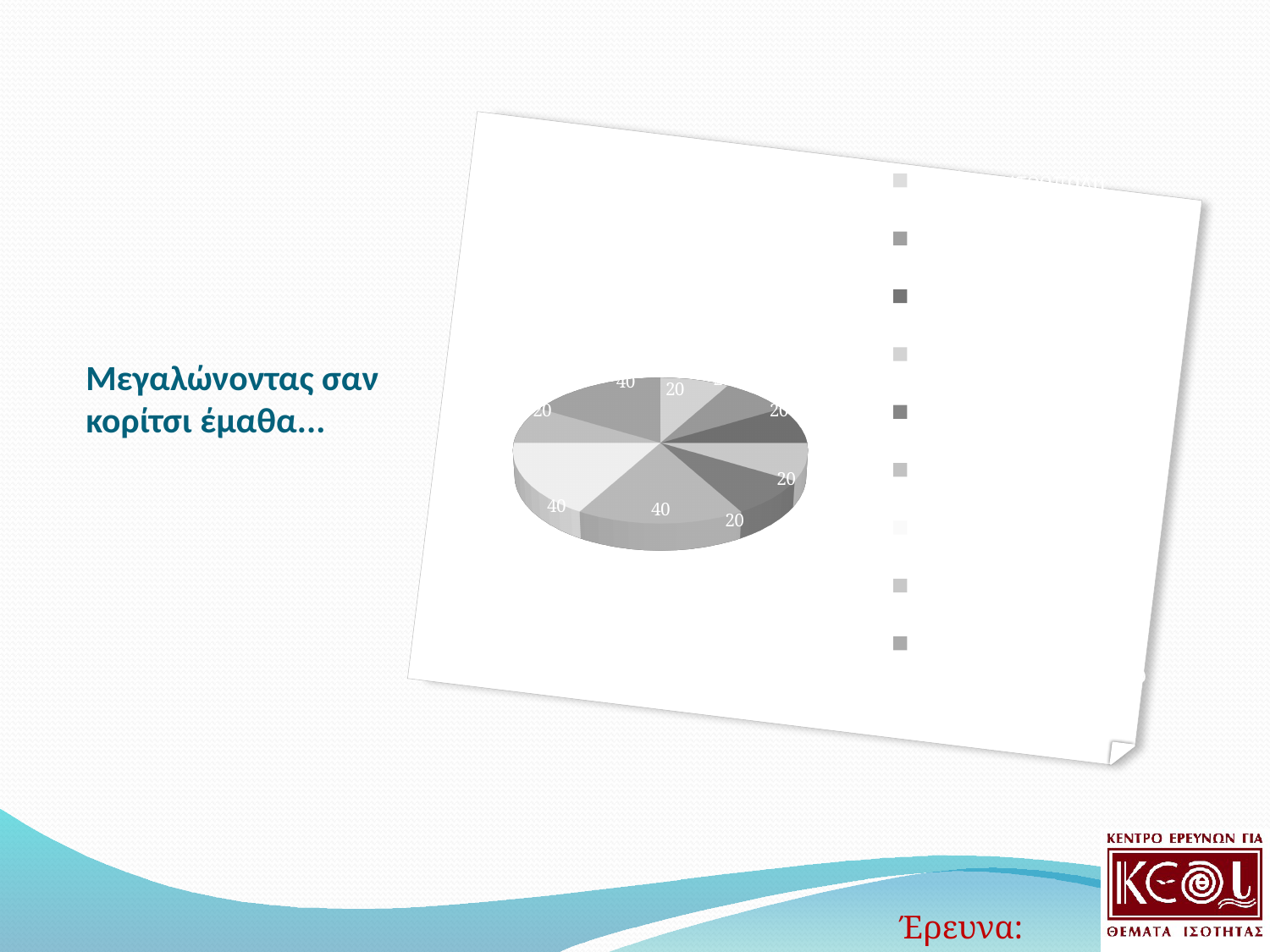
What kind of chart is shown on the slide? pie chart What is the largest data label value printed on the pie chart? 40 What is the smallest data label value printed on the pie chart? 20 Are the slices of the pie chart coloured in shades of grey or in multiple colours? shades of grey How many entries does the legend of the pie chart list? 9 Is the pie chart drawn in 3D or flat 2D? 3D